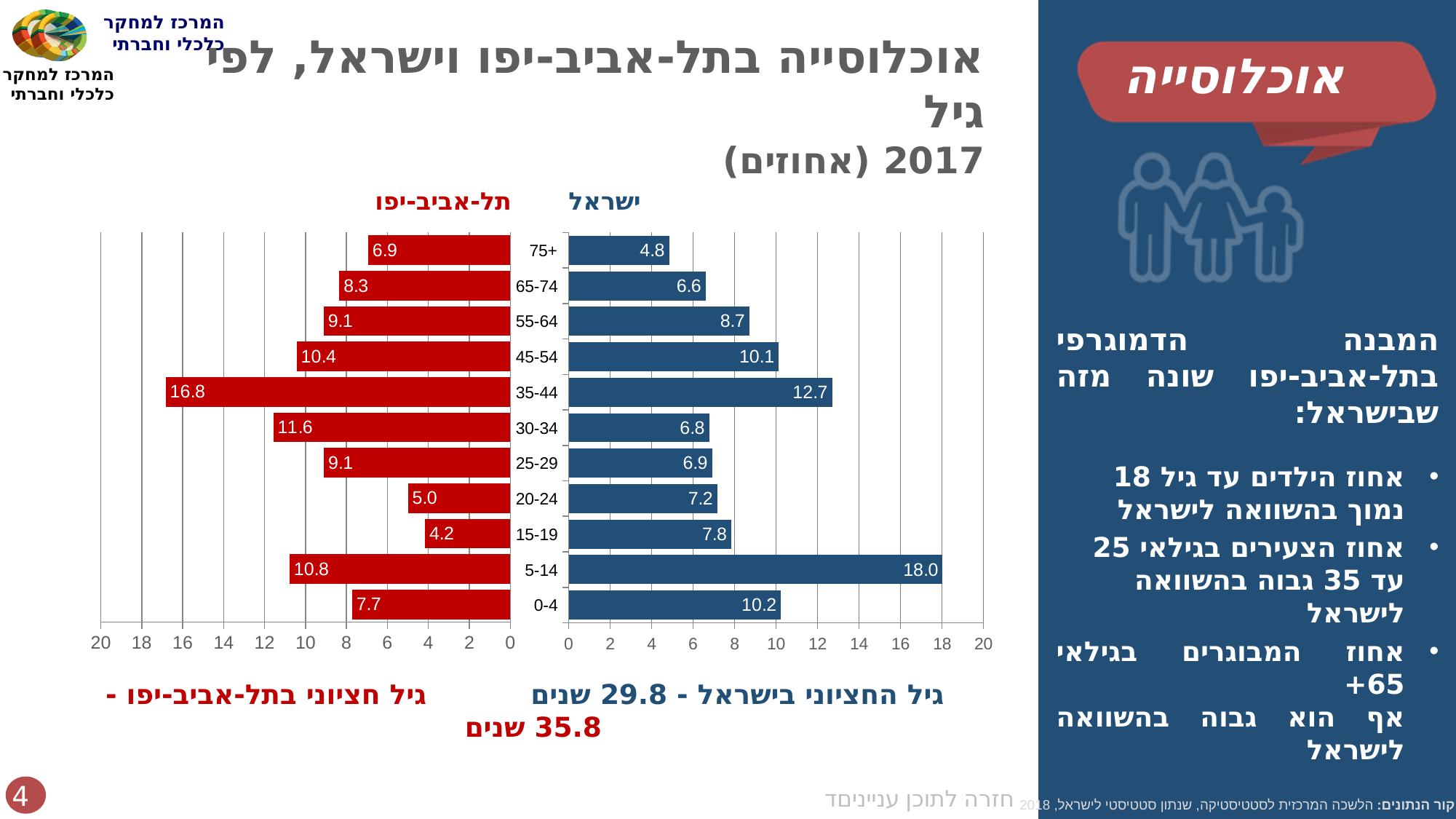
What is the value for the 5-14 age group in the Israel (blue, right) chart? 18.0 What kind of chart is used on this slide? Bar chart Which age group has the highest value in the Tel Aviv-Yafo (red, left) chart? 35-44 For the 30-34 age group, which is larger: the Tel Aviv-Yafo value or the Israel value? Tel Aviv-Yafo Which age group has the lowest value in the Israel (blue, right) chart? 75+ What is the difference between the Israel and Tel Aviv-Yafo values for the 5-14 age group? 7.2 What is the value for the 75+ age group in the Israel (blue, right) chart? 4.8 What colour are the bars for Tel Aviv-Yafo? Red How many age groups are shown in each chart? 11 Which age group has the lowest value in the Tel Aviv-Yafo (red, left) chart? 15-19 What is the value for the 35-44 age group in the Tel Aviv-Yafo (red, left) chart? 16.8 What is the difference between the Tel Aviv-Yafo and Israel values for the 35-44 age group? 4.1